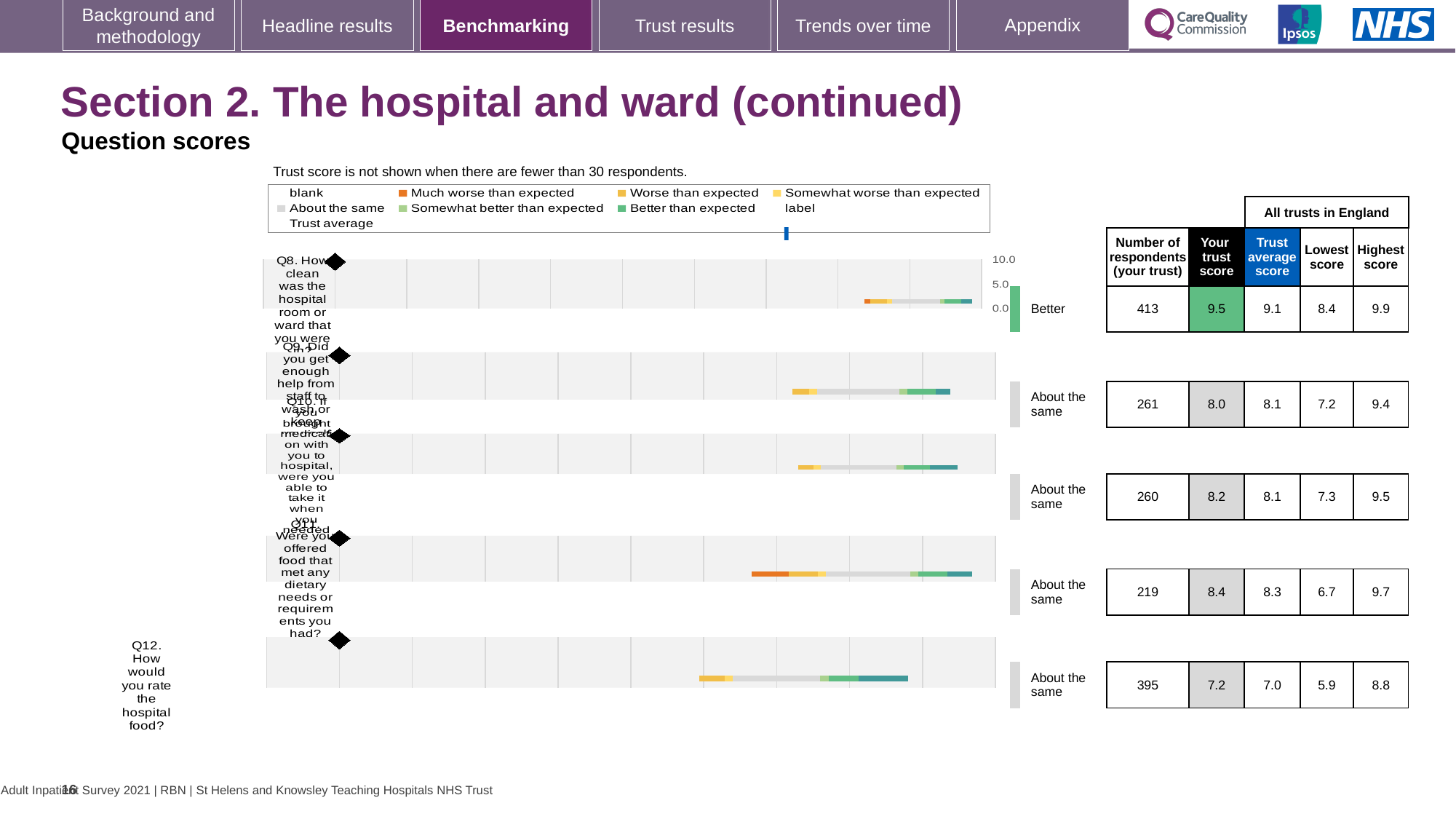
What kind of chart is used to show the question scores on this slide? bar chart What is the trust average score for Q11 (offered food that met dietary needs)? 8.3 How many respondents answered Q12 (how would you rate the hospital food)? 395 Which question has the lowest trust score? Q12 Which question has the highest trust score? Q8 What is the lowest score across all trusts in England for Q12? 5.9 How many questions (categories) are plotted in the question scores chart? 5 For Q10, which is larger: the trust score or the trust average score? the trust score (8.2) What is the difference between the highest score and the lowest score for Q8? 1.5 Which benchmark category is shown for Q8? Better How many questions are rated 'About the same'? 4 What is the trust score for Q8 (how clean was the hospital room or ward)? 9.5